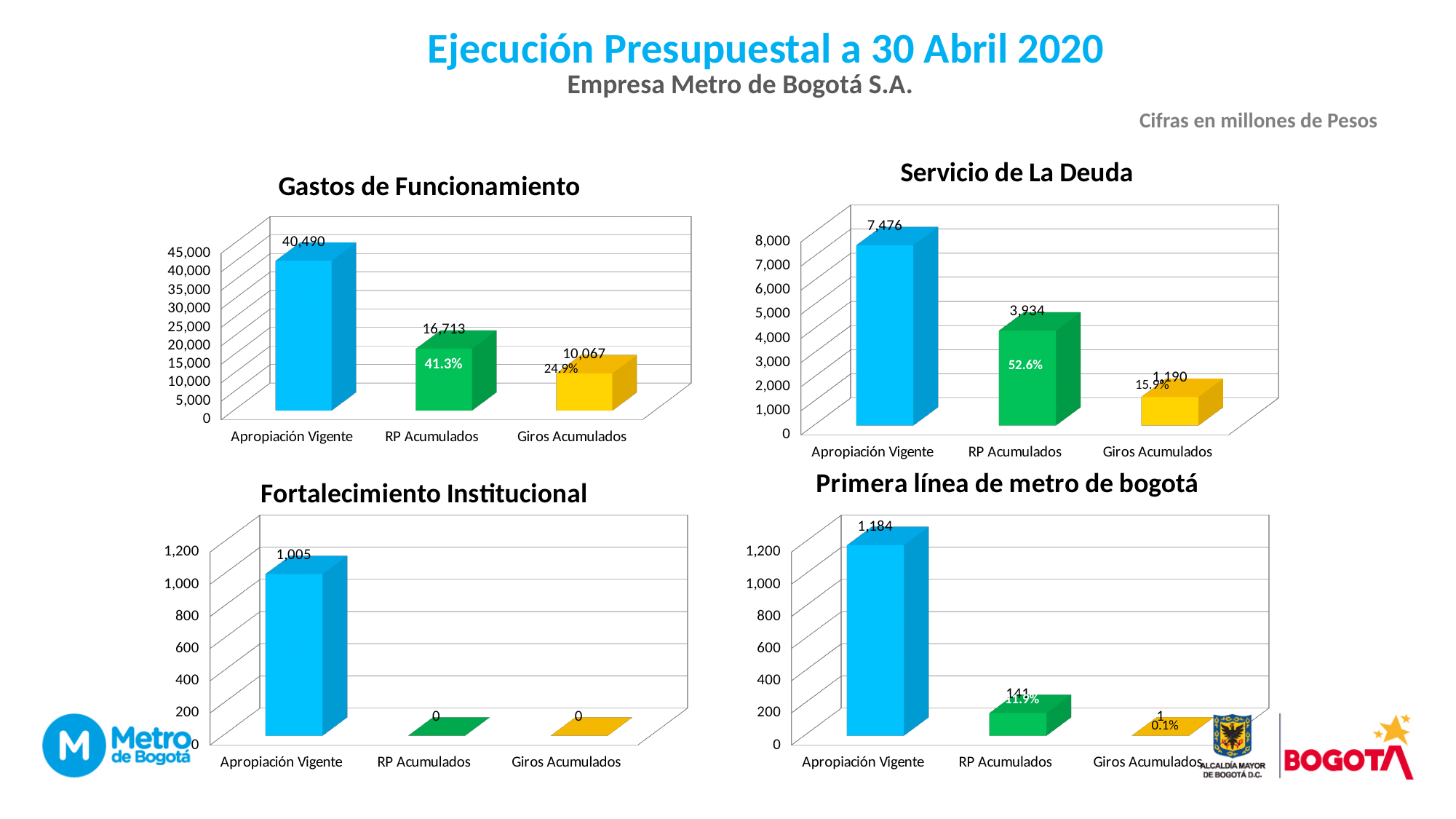
In the Servicio de La Deuda chart, what is the value for Giros Acumulados? 1,190 In the Gastos de Funcionamiento chart, which category has the lowest value? Giros Acumulados In the Fortalecimiento Institucional chart, what is the value for RP Acumulados? 0 In the Gastos de Funcionamiento chart, what is the value for RP Acumulados? 16,713 In the Primera línea de metro de bogotá chart, what is the value for Apropiación Vigente? 1,184 In the Gastos de Funcionamiento chart, what is the difference between Apropiación Vigente and RP Acumulados? 23,777 What kind of chart is the Servicio de La Deuda chart? Bar chart In the Gastos de Funcionamiento chart, what is the value for Apropiación Vigente? 40,490 In the Primera línea de metro de bogotá chart, which is larger, RP Acumulados or Giros Acumulados? RP Acumulados In the Servicio de La Deuda chart, what is the difference between Apropiación Vigente and RP Acumulados? 3,542 In the Servicio de La Deuda chart, which category has the highest value? Apropiación Vigente How many categories does the Fortalecimiento Institucional chart show? 3